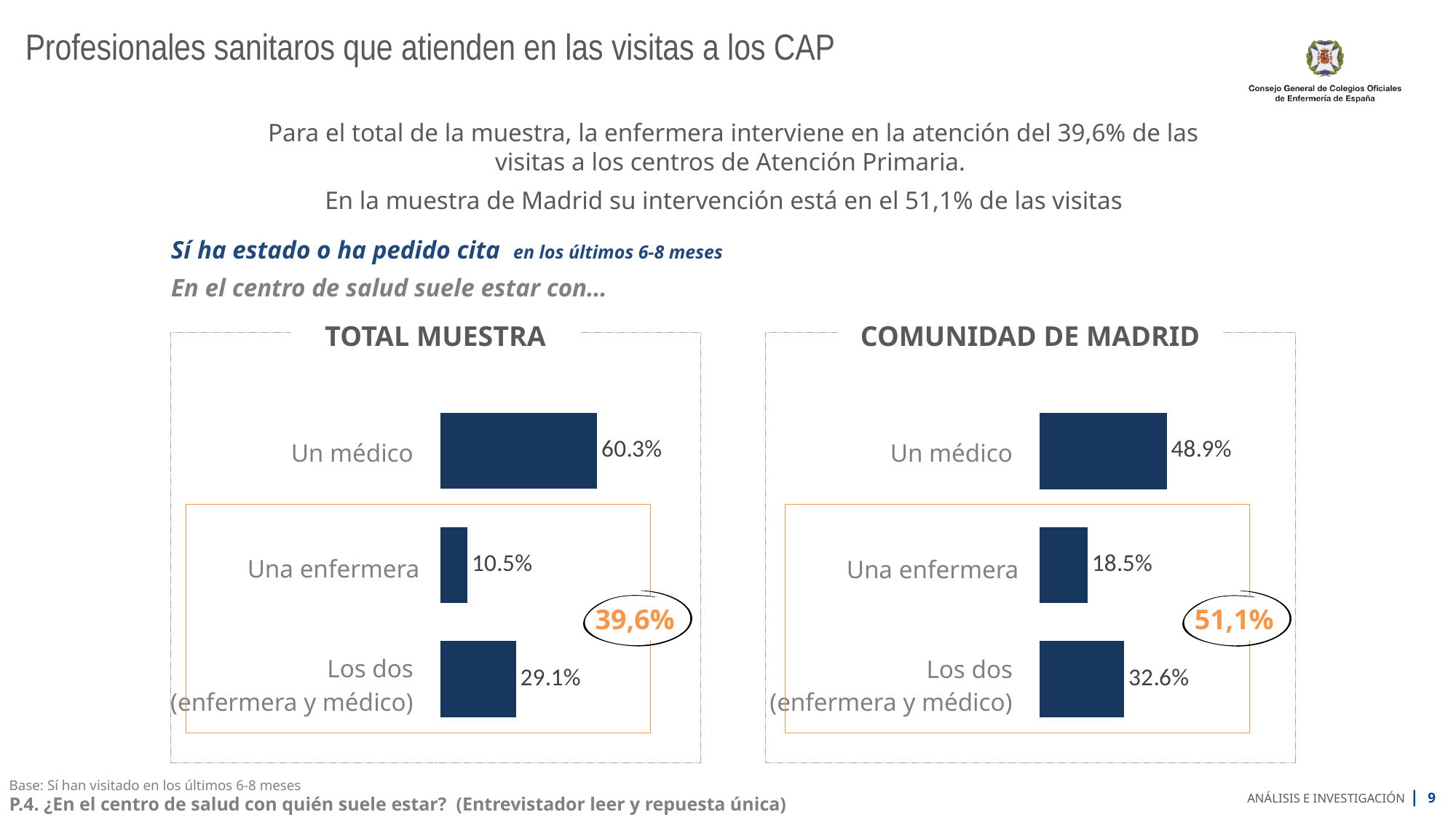
Which is larger: Una enfermera in the TOTAL MUESTRA chart or Una enfermera in the COMUNIDAD DE MADRID chart? COMUNIDAD DE MADRID In the COMUNIDAD DE MADRID chart, what is the difference between Un médico and Una enfermera? 30.4% In the TOTAL MUESTRA chart, what is the value for Una enfermera? 10.5% In the TOTAL MUESTRA chart, what is the difference between Un médico and Los dos (enfermera y médico)? 31.2% In the COMUNIDAD DE MADRID chart, which category has the lowest value? Una enfermera In the TOTAL MUESTRA chart, what is the value for Un médico? 60.3% In the COMUNIDAD DE MADRID chart, what is the value for Una enfermera? 18.5% How many categories does the TOTAL MUESTRA chart show? 3 What is the highlighted combined value shown in the orange circle on the COMUNIDAD DE MADRID chart? 51,1% What kind of chart is the COMUNIDAD DE MADRID chart? Bar chart In the TOTAL MUESTRA chart, which category has the highest value? Un médico In the COMUNIDAD DE MADRID chart, what is the value for Los dos (enfermera y médico)? 32.6%